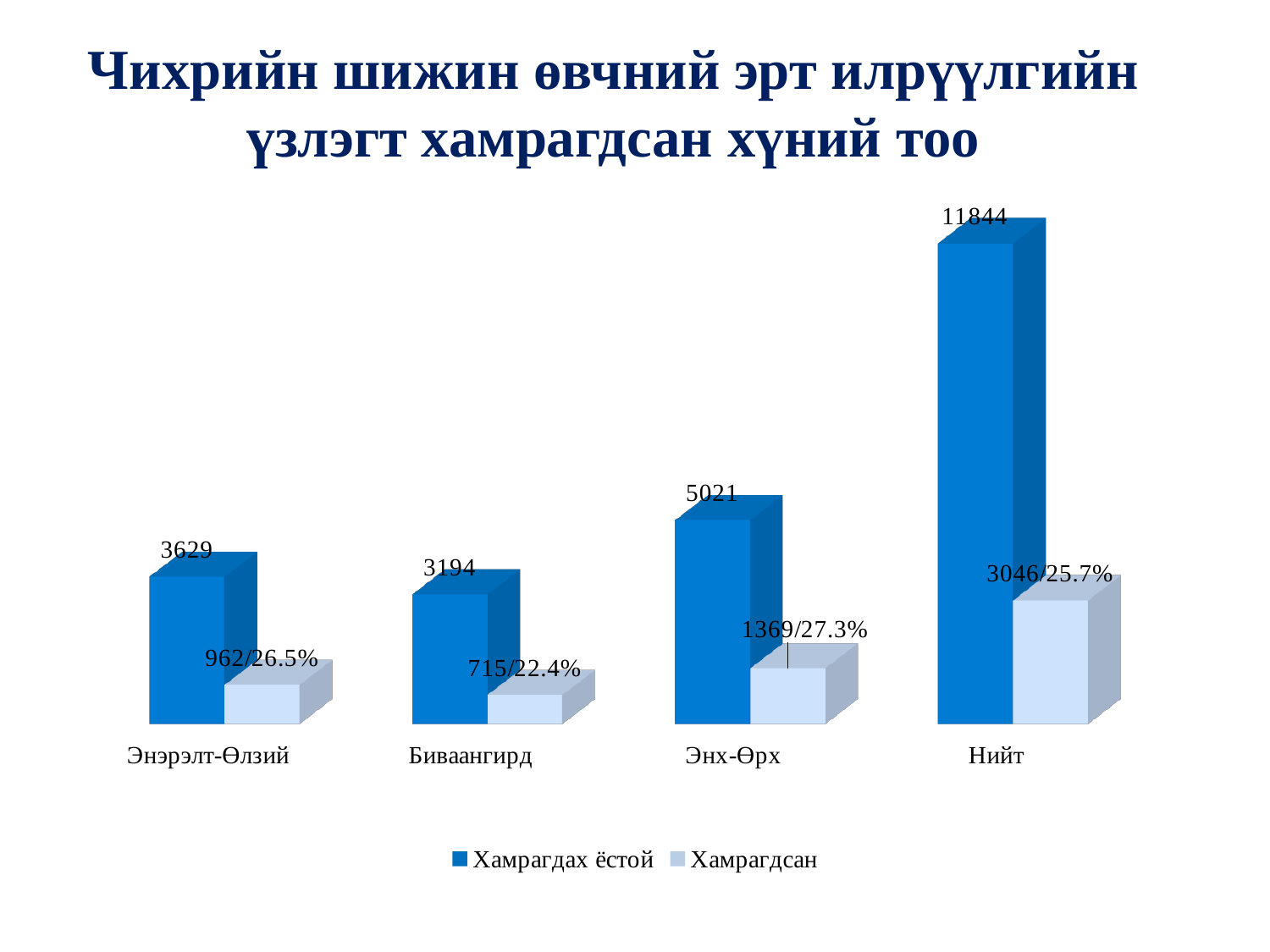
What kind of chart is shown on the slide? Bar chart How many series does the legend list? 2 Which series is shown in dark blue according to the legend? Хамрагдах ёстой What is the value of Хамрагдах ёстой for Энх-Өрх? 5021 How many categories are shown on the x axis? 4 What is the difference between the Хамрагдах ёстой values for Энэрэлт-Өлзий and Биваангирд? 435 What is the value of Хамрагдах ёстой for Нийт? 11844 What is the data label shown for Хамрагдсан for Биваангирд? 715/22.4% Which category has the highest Хамрагдах ёстой value? Нийт What is the data label shown for Хамрагдсан for Энэрэлт-Өлзий? 962/26.5% Which is larger, the Хамрагдах ёстой value for Энх-Өрх or for Энэрэлт-Өлзий? Энх-Өрх Which category has the lowest Хамрагдах ёстой value? Биваангирд